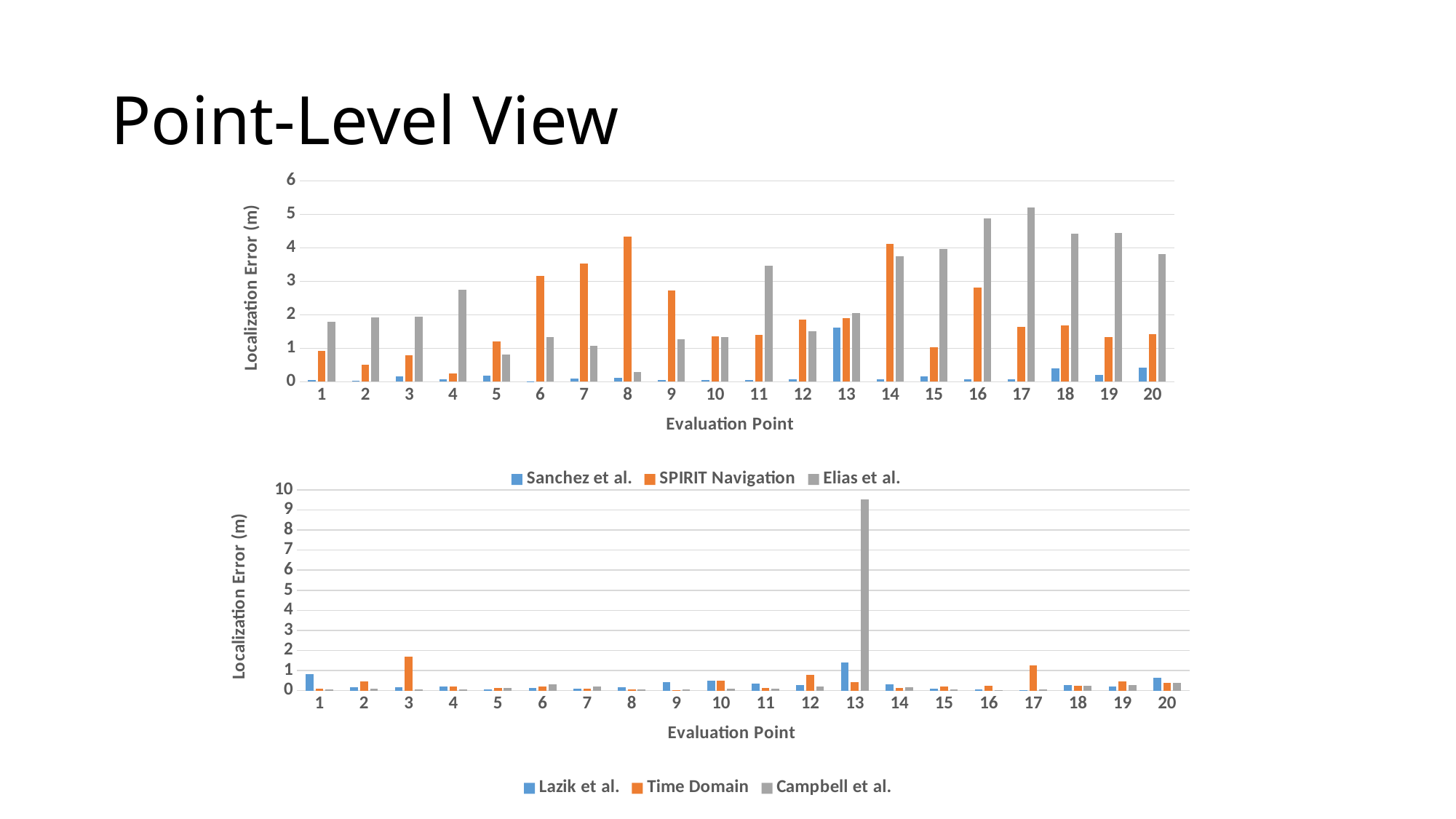
How many evaluation points are shown on the x axis of the top chart? 20 In the top chart, is the SPIRIT Navigation value at evaluation point 8 greater or less than 4? greater In the top chart, which series does the grey colour represent? Elias et al. In the top chart, is the Elias et al. value at evaluation point 17 greater or less than 5? greater How many series does the legend of the bottom chart list? 3 How many series does the legend of the top chart list? 3 In the top chart, at which evaluation point is the Elias et al. localization error highest? 17 What is the y-axis label of the bottom chart? Localization Error (m) In the bottom chart, at which evaluation point is the Time Domain localization error highest? 3 In the bottom chart, is the Campbell et al. value at evaluation point 13 greater or less than 9? greater In the top chart, at evaluation point 8, which series has the larger localization error: SPIRIT Navigation or Elias et al.? SPIRIT Navigation What type of chart is the top chart on the slide? bar chart